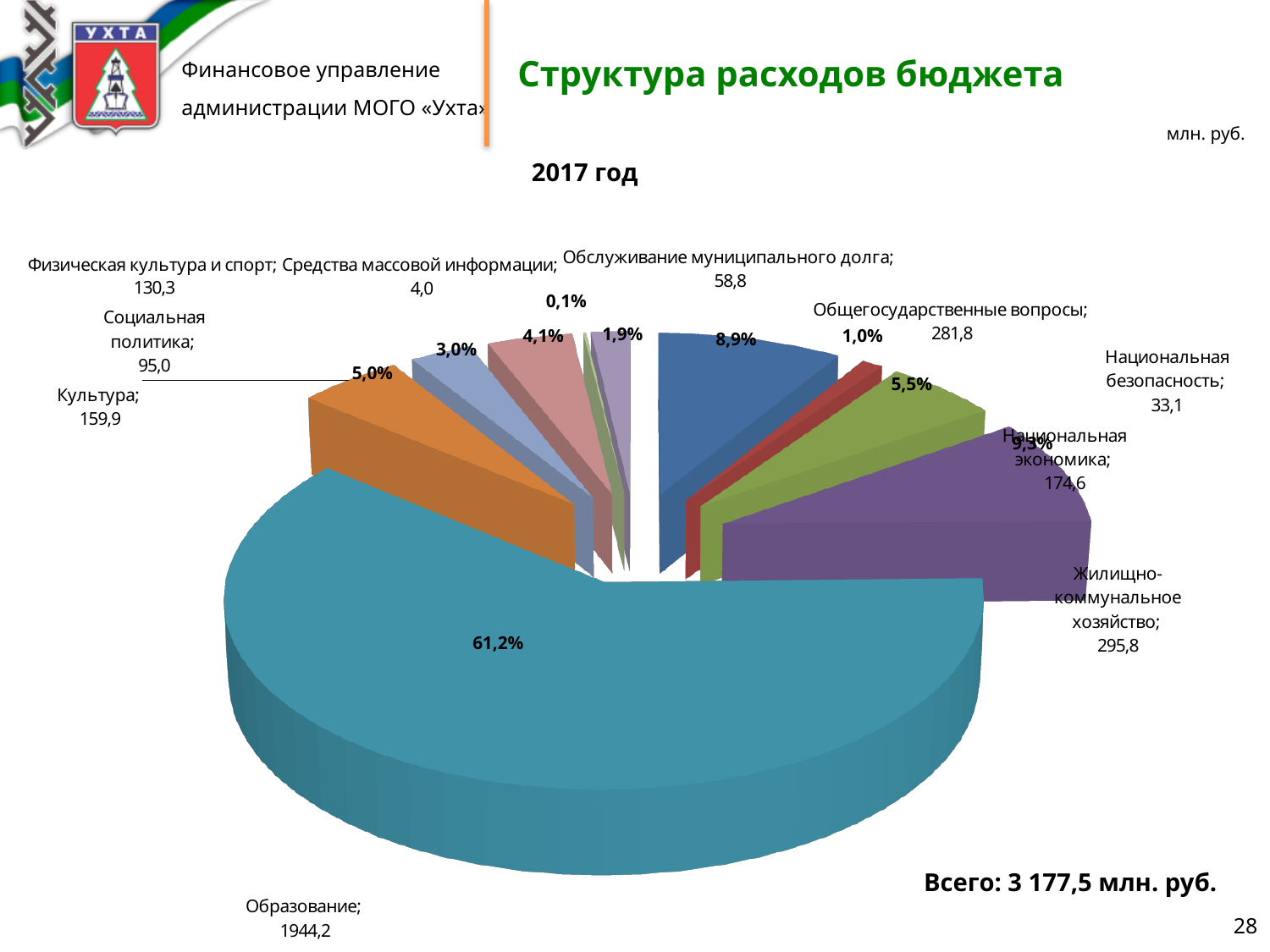
How many categories does the pie chart show? 10 Which is larger, the value for Культура or the value for Социальная политика? Культура Which category has the smallest share of the pie? Средства массовой информации Which category has the largest share of the pie? Образование What is the value for Образование? 1944,2 What is the value for Жилищно-коммунальное хозяйство? 295,8 What percentage share of the pie does Жилищно-коммунальное хозяйство have? 9,3% What percentage share of the pie does Образование have? 61,2% What is the difference between the values for Жилищно-коммунальное хозяйство and Общегосударственные вопросы? 14,0 What is the value for Общегосударственные вопросы? 281,8 What kind of chart is shown on the slide? pie chart What is the value for Средства массовой информации? 4,0